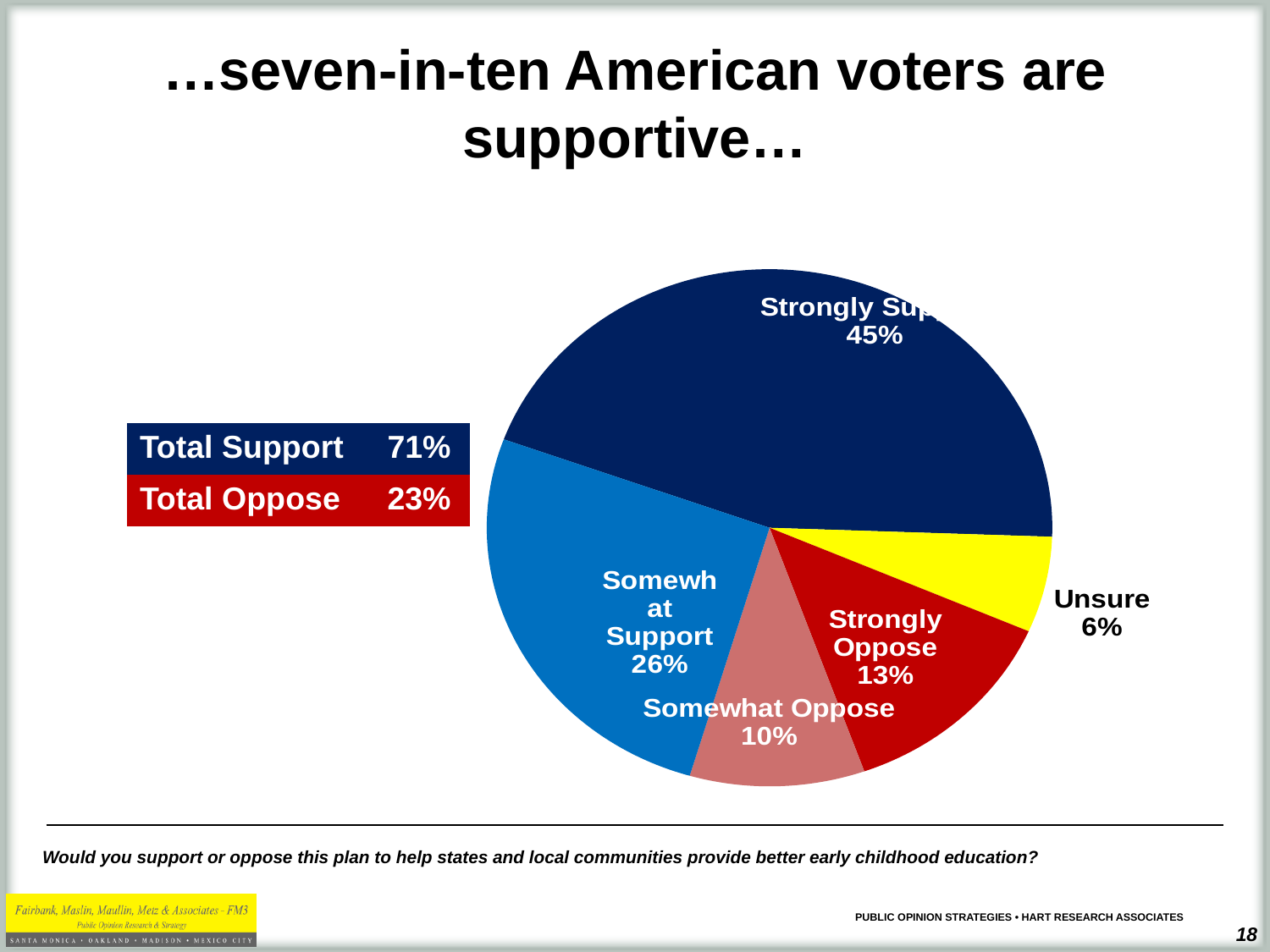
What is the difference between the Strongly Support and Somewhat Support percentages? 19% What kind of chart is shown on the slide? pie chart Which is larger, Strongly Oppose or Somewhat Oppose? Strongly Oppose What percentage of voters are unsure? 6% What percentage of voters somewhat support the plan? 26% What percentage of voters strongly oppose the plan? 13% Which slice of the pie chart is the smallest? Unsure What percentage of voters somewhat oppose the plan? 10% What percentage of voters strongly support the plan? 45% What is the Total Support percentage shown in the box on the slide? 71% Which slice of the pie chart is the largest? Strongly Support How many slices does the pie chart have? 5